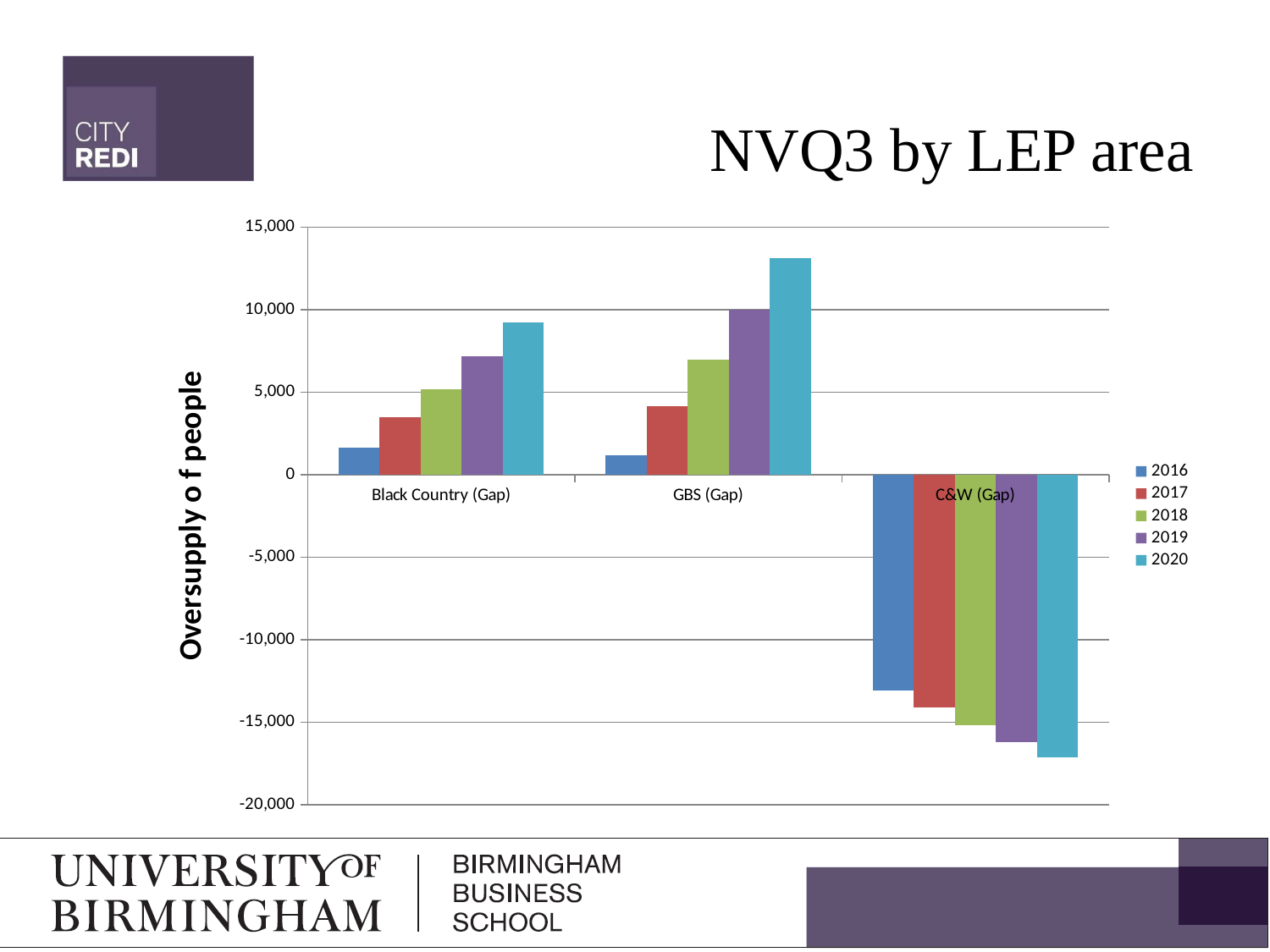
How many LEP area categories are shown on the x axis? 3 Which category has the highest value for 2020? GBS (Gap) What kind of chart is shown on the slide? bar chart For Black Country (Gap), do the values rise or fall from 2016 to 2020? rise Which is larger, the 2020 value for Black Country (Gap) or the 2020 value for GBS (Gap)? GBS (Gap) Is the 2020 value for C&W (Gap) greater or less than -15,000? less How many series does the legend list? 5 Is the 2018 value for GBS (Gap) greater or less than 5,000? greater Is the 2020 value for Black Country (Gap) greater or less than 10,000? less Which category has the lowest value for 2020? C&W (Gap) What is the title of the y axis? Oversupply of people